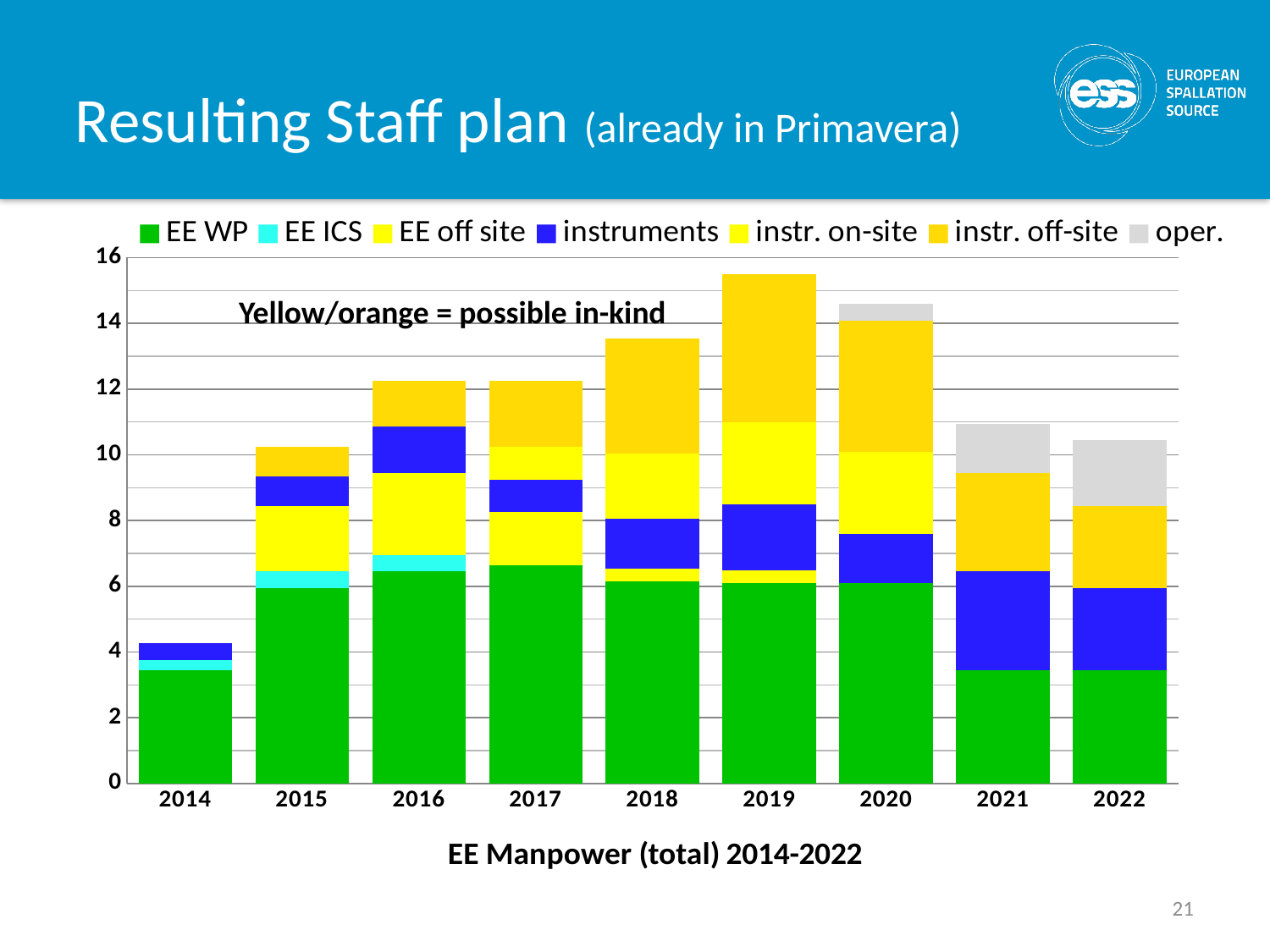
How many series does the chart legend list? 7 Is the total for 2019 greater or less than 14? greater Do the total bar heights rise or fall from 2014 to 2019? rise What kind of chart is shown on the slide? Stacked bar chart How many years are shown on the x axis of the chart? 9 Which year has the lowest total bar? 2014 According to the annotation on the chart, what do the yellow/orange segments represent? possible in-kind Which year has the larger total bar, 2017 or 2018? 2018 Is the total for 2014 greater or less than 6? less Which year has the highest total bar? 2019 Is the total for 2018 greater or less than 12? greater What is the title of the chart? EE Manpower (total) 2014-2022